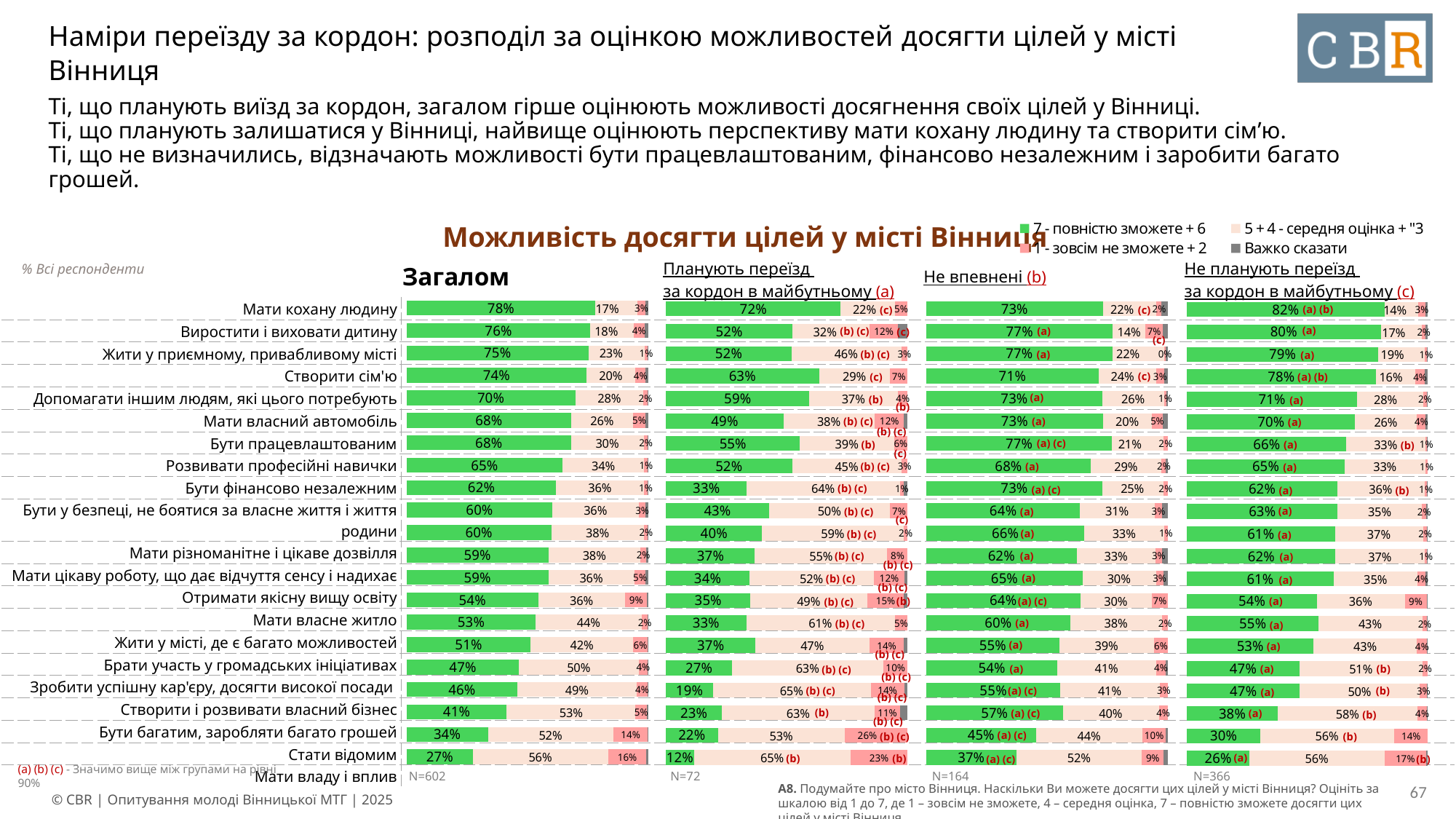
In the 'Не впевнені (b)' chart, what is the green segment value for 'Виростити і виховати дитину'? 77% In the 'Не планують переїзд за кордон в майбутньому (c)' chart, what is the green segment value for 'Мати кохану людину'? 82% For 'Бути працевлаштованим', which chart shows a larger green segment: 'Не впевнені (b)' or 'Не планують переїзд за кордон в майбутньому (c)'? Не впевнені (b) What is the sample size (N) shown under the 'Планують переїзд за кордон в майбутньому (a)' chart? N=72 What is the difference between the green segment for 'Мати кохану людину' in the 'Загалом' chart and in the 'Планують переїзд за кордон в майбутньому (a)' chart? 6 percentage points In the 'Загалом' chart, what percentage is shown for the green '7 - повністю зможете + 6' segment for 'Мати кохану людину'? 78% In the 'Планують переїзд за кордон в майбутньому (a)' chart, what is the green segment value for 'Бути фінансово незалежним'? 33% In the 'Загалом' chart, what is the value of the middle '5 + 4 - середня оцінка + 3' segment for 'Жити у приємному, привабливому місті'? 23% What kind of chart is used on this slide? Stacked bar chart In the 'Загалом' chart, which category has the highest green '7 - повністю зможете + 6' value? Мати кохану людину How many series does the legend list? 4 In the 'Планують переїзд за кордон в майбутньому (a)' chart, what is the value of the '1 - зовсім не зможете + 2' segment for 'Мати власний автомобіль'? 12%